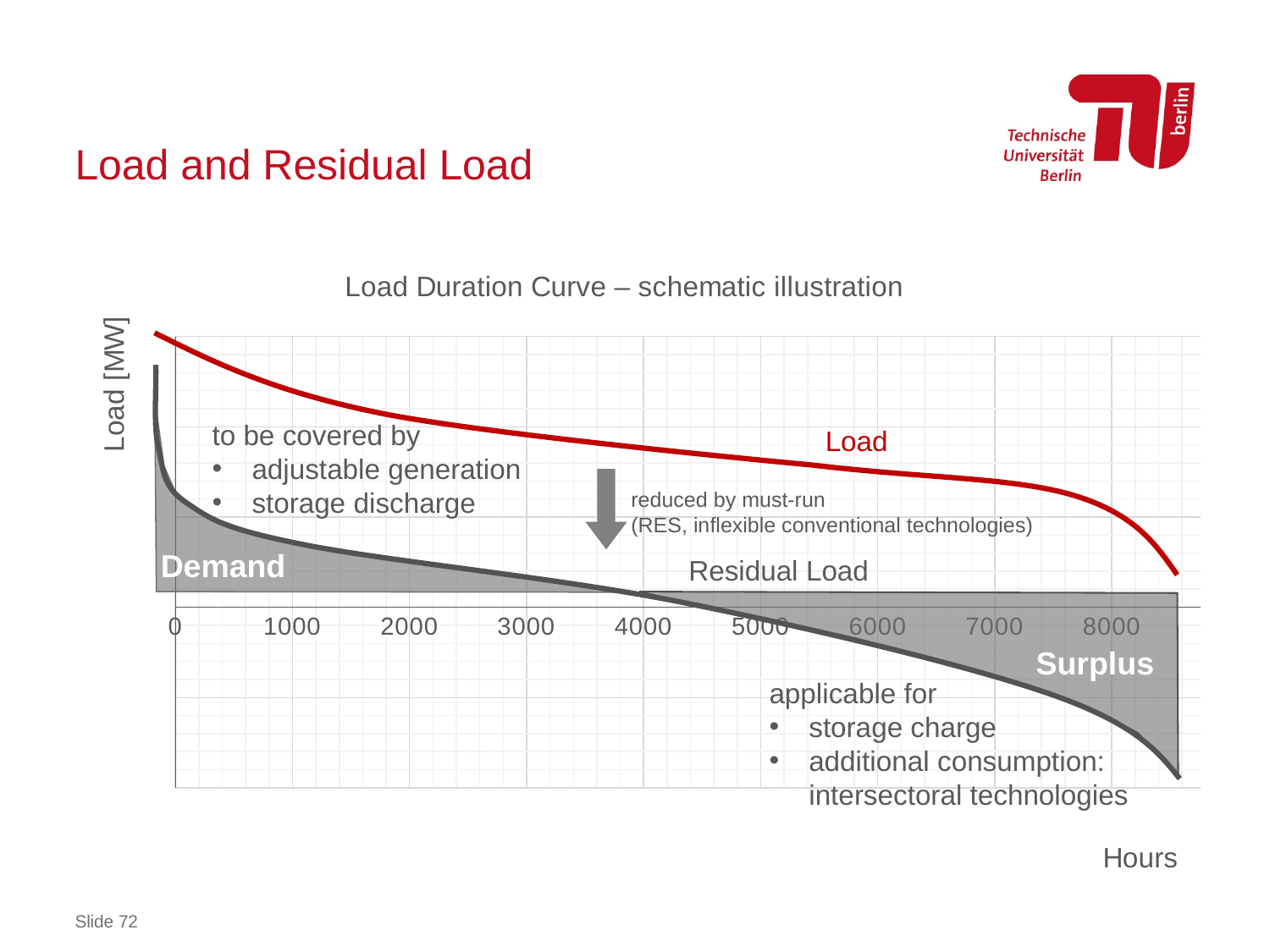
Is the Load value at 8000 hours greater or less than 0? greater How many curves (series) are plotted on the chart? 2 What is the label of the vertical axis? Load [MW] Does the Residual Load curve rise or fall as hours increase along the x axis? fall Which curve is higher at 7000 hours, Load or Residual Load? Load Is the Residual Load value at 6000 hours greater or less than 0? less What kind of chart is shown on the slide? line chart What is the largest tick value shown on the Hours axis? 8000 What is the title of the chart? Load Duration Curve – schematic illustration Is the Residual Load value at 2000 hours greater or less than 0? greater Does the Load curve rise or fall as hours increase along the x axis? fall Which curve is higher at 2000 hours, Load or Residual Load? Load